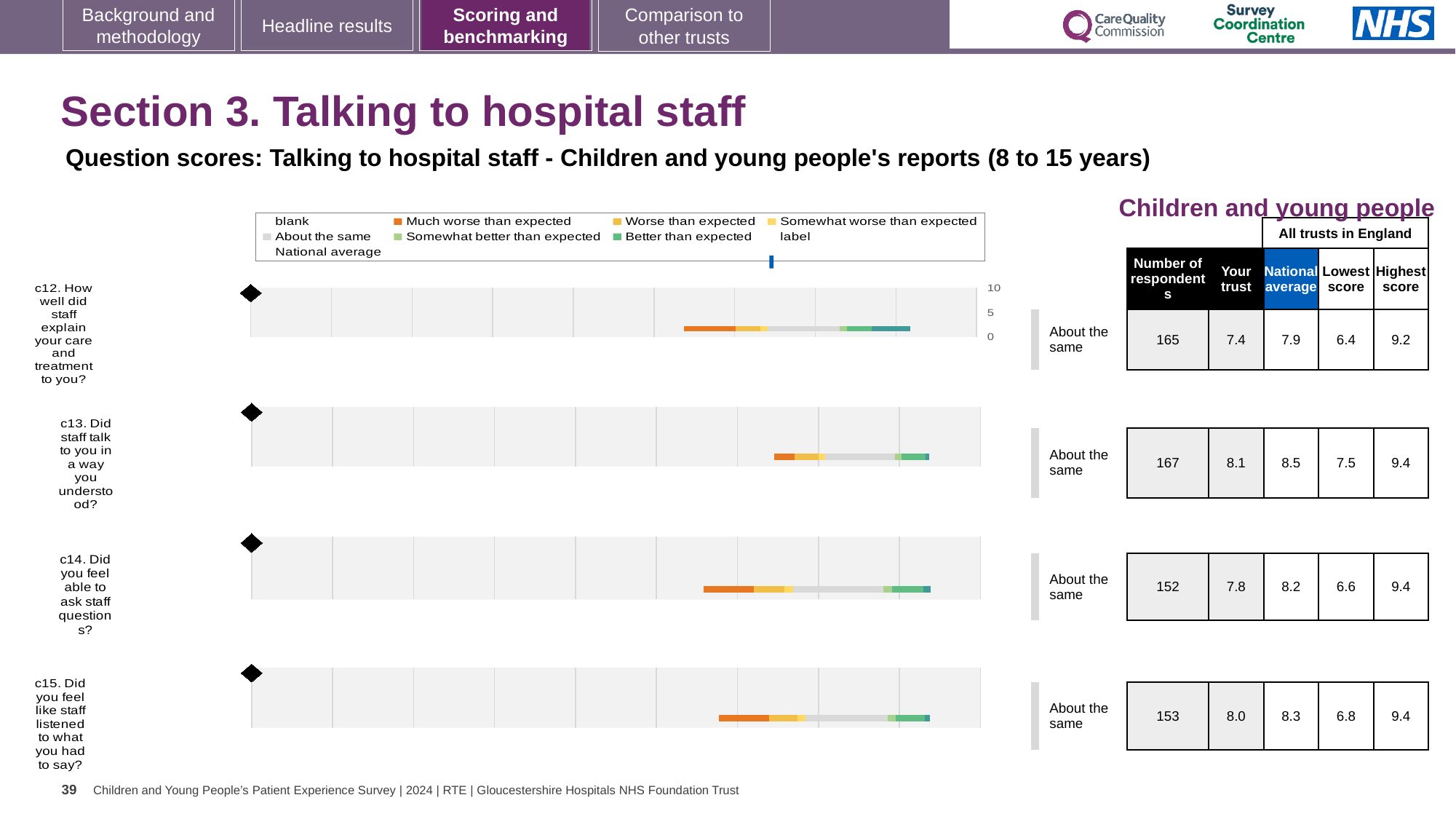
Which question has the highest 'Your trust' score? c13 What is the 'Your trust' score for c12 (How well did staff explain your care and treatment to you?)? 7.4 For c14, is the 'Your trust' score higher or lower than the national average? Lower What is the national average for c14 (Did you feel able to ask staff questions?)? 8.2 What is the number of respondents for c13 (Did staff talk to you in a way you understood?)? 167 What is the lowest score across all trusts in England for c12? 6.4 What benchmark category is shown next to each of the four questions? About the same What is the highest score across all trusts in England for c15 (Did you feel like staff listened to what you had to say?)? 9.4 How many question charts are shown on the slide? 4 Which question has the lowest 'Your trust' score? c12 What kind of chart is used for each question (c12 to c15)? Bar chart What is the difference between the national average and the 'Your trust' score for c12? 0.5